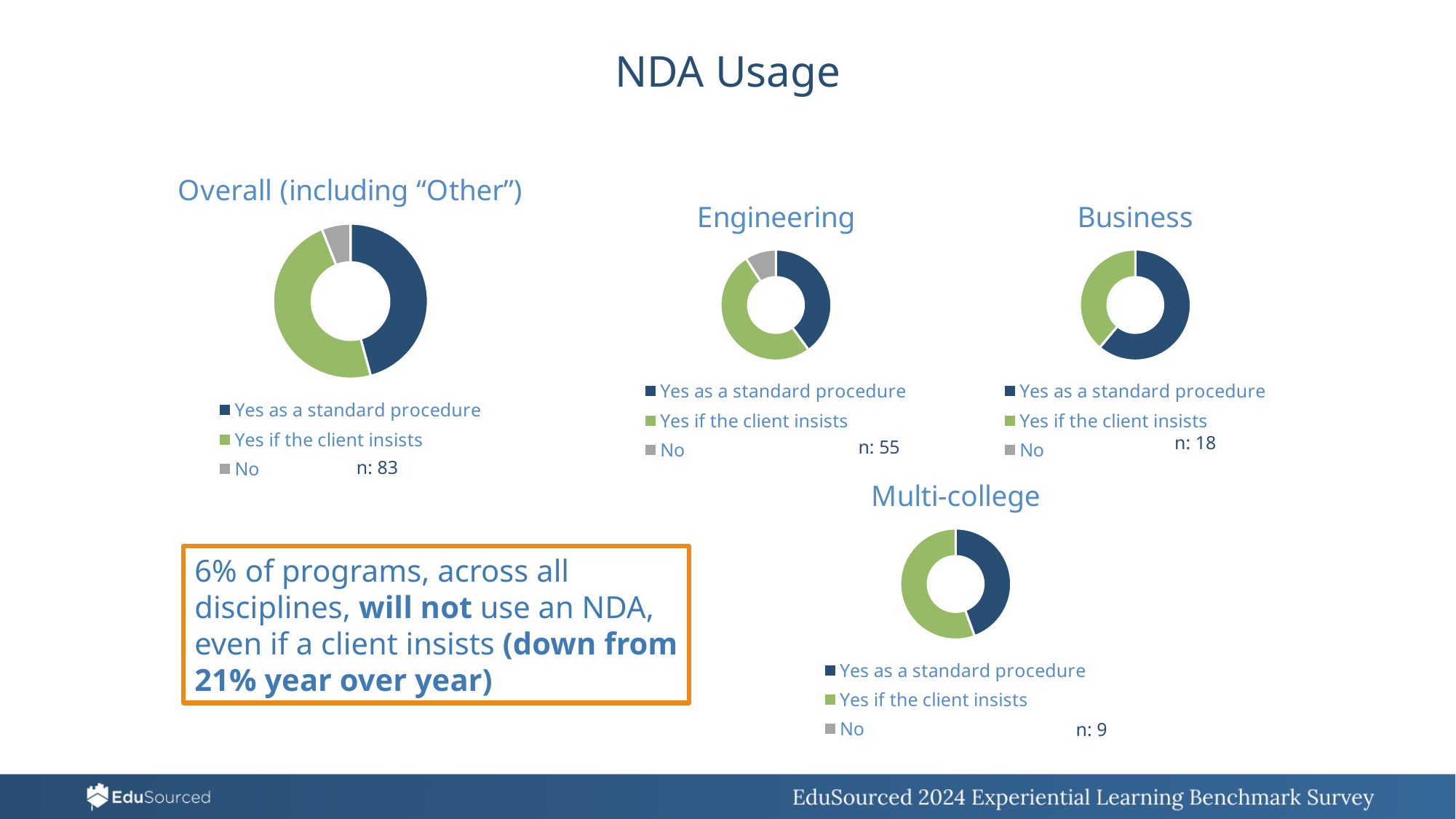
In the Engineering chart, which is larger: "Yes as a standard procedure" or "Yes if the client insists"? Yes if the client insists In the Engineering chart, which category has the smallest share? No How many entries does the legend of the Engineering chart list? 3 In the Multi-college chart, which is larger: "Yes as a standard procedure" or "Yes if the client insists"? Yes if the client insists In the Overall (including "Other") chart, which category has the smallest share? No What is the sample size (n) shown for the Multi-college chart? n: 9 In the Business chart, which category has the largest share? Yes as a standard procedure How many charts are shown on the slide? 4 What kind of chart is used for the Overall (including "Other") chart? Donut chart What is the sample size (n) shown for the Engineering chart? n: 55 According to the slide, what percentage of programs across all disciplines will not use an NDA even if a client insists? 6%